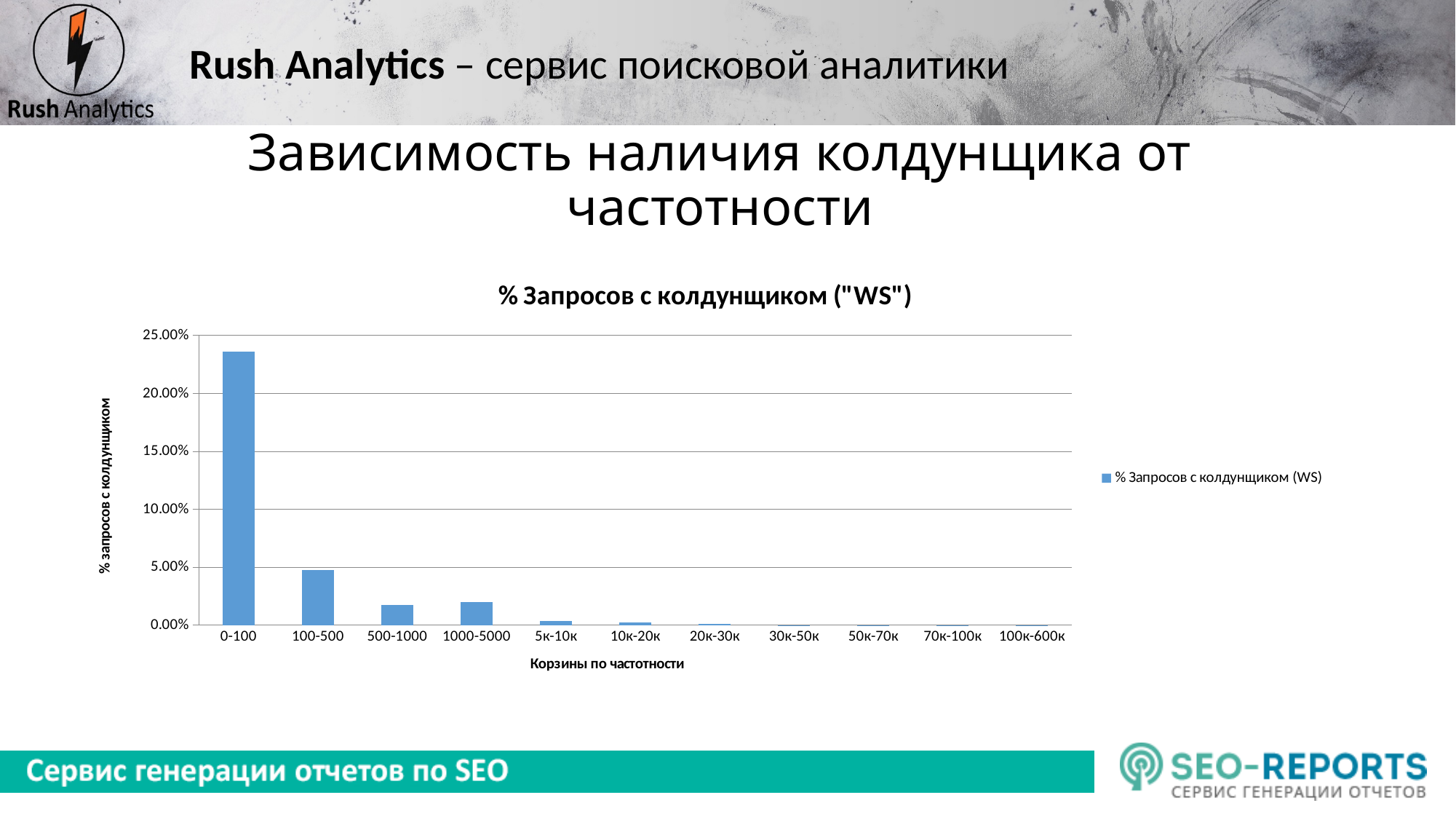
Which frequency bin has the highest share of queries with a "колдунщик"? 0-100 Is the value for the 0-100 bin greater or less than 20.00%? greater How many series does the chart legend list? 1 Which bin has a larger value, 100-500 or 500-1000? 100-500 Is the value for the 1000-5000 bin greater or less than 10.00%? less What is the title of the chart? % Запросов с колдунщиком ("WS") Is the value for the 500-1000 bin greater or less than 5.00%? less What kind of chart is shown on the slide? bar chart Which bin has a larger value, 0-100 or 100-500? 0-100 How many frequency bins (categories) are shown on the x axis of the chart? 11 Do the values generally rise or fall as the frequency bins increase along the x axis? fall